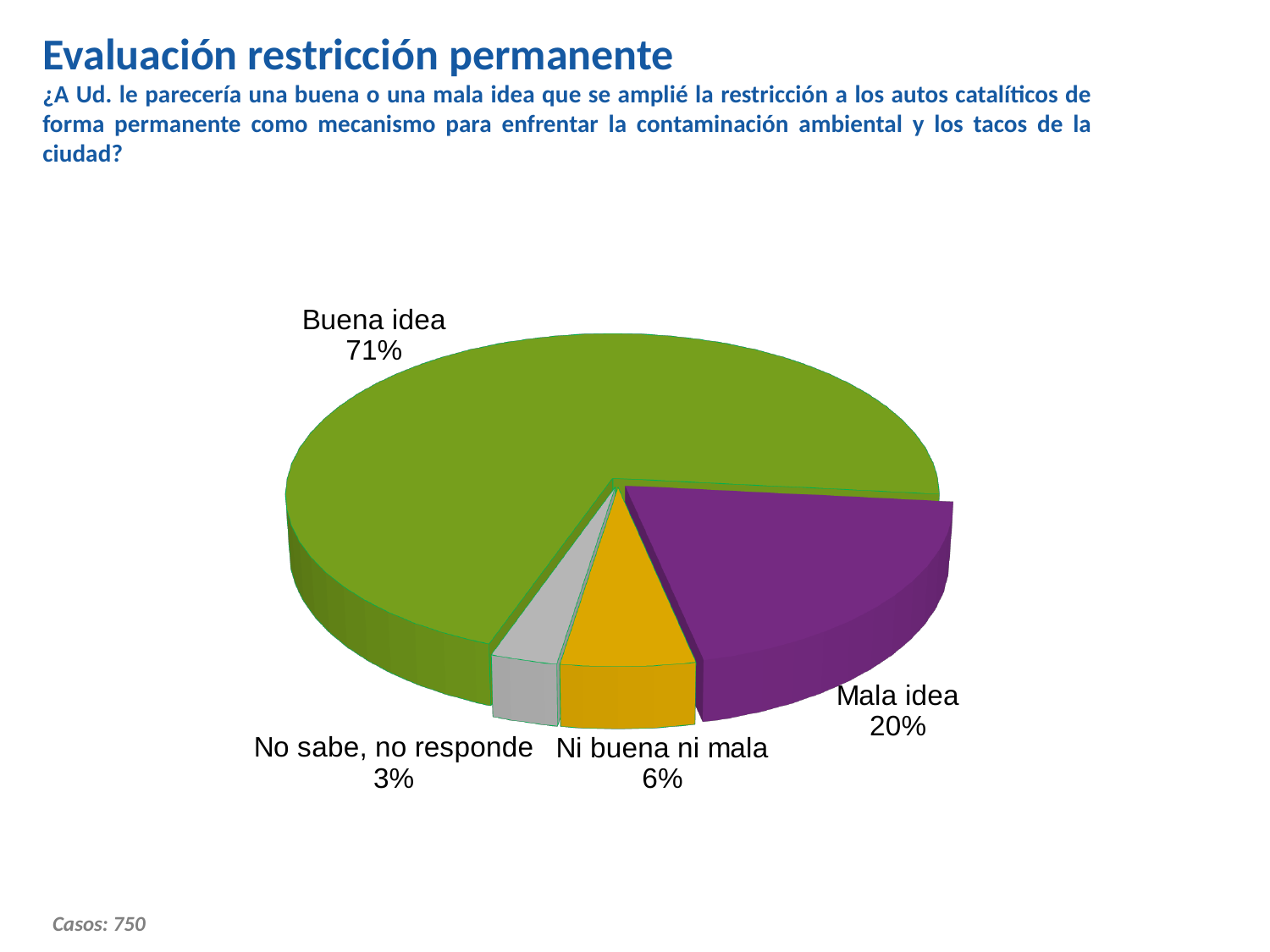
What percentage of respondents answered "Ni buena ni mala"? 6% What percentage of respondents answered "Buena idea"? 71% How many slices does the pie chart have? 4 What kind of chart is shown on the slide? Pie chart Which is larger, the share for "Mala idea" or the share for "Ni buena ni mala"? Mala idea What is the combined share of "Ni buena ni mala" and "No sabe, no responde"? 9% What is the difference in percentage points between "Buena idea" and "Mala idea"? 51 Which response has the smallest share of the pie? No sabe, no responde What percentage of respondents answered "No sabe, no responde"? 3% Which response has the largest share of the pie? Buena idea What percentage of respondents answered "Mala idea"? 20% What colour is the "Mala idea" slice? Purple